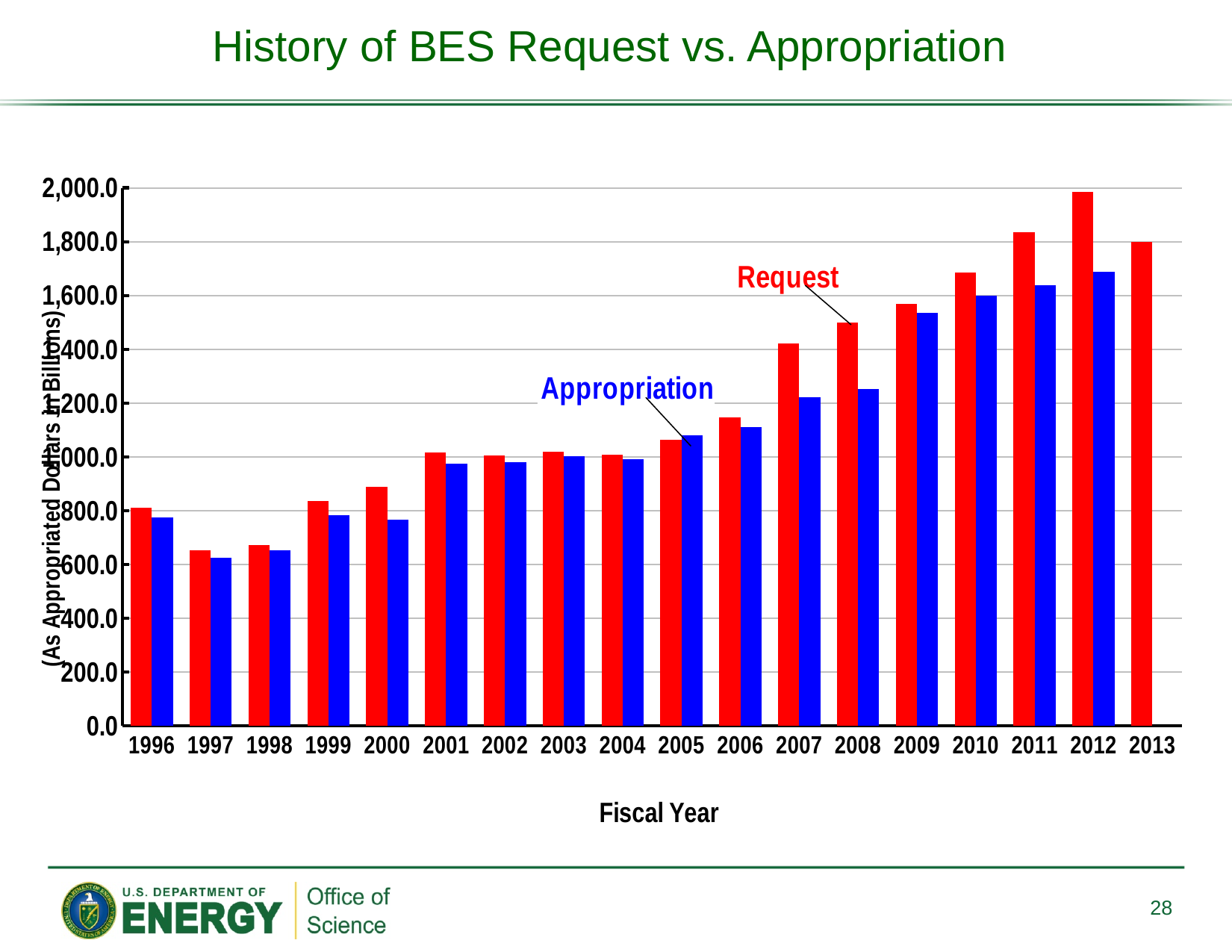
Which fiscal year has a Request bar but no Appropriation bar? 2013 In which fiscal year is the Request value lowest? 1997 In which fiscal year is the Appropriation value lowest? 1997 How many fiscal years are shown on the x axis? 18 Is the Request value for 2008 greater or less than 1,400.0? greater Is the Appropriation value for 2008 greater or less than 1,400.0? less What kind of chart is shown on the slide? Bar chart In which fiscal year is the Appropriation value highest? 2012 How many data series are plotted in the chart? 2 In which fiscal year is the Request value highest? 2012 Do the Request values rise or fall from 2007 to 2012? Rise For fiscal year 2011, which is larger, the Request or the Appropriation? Request